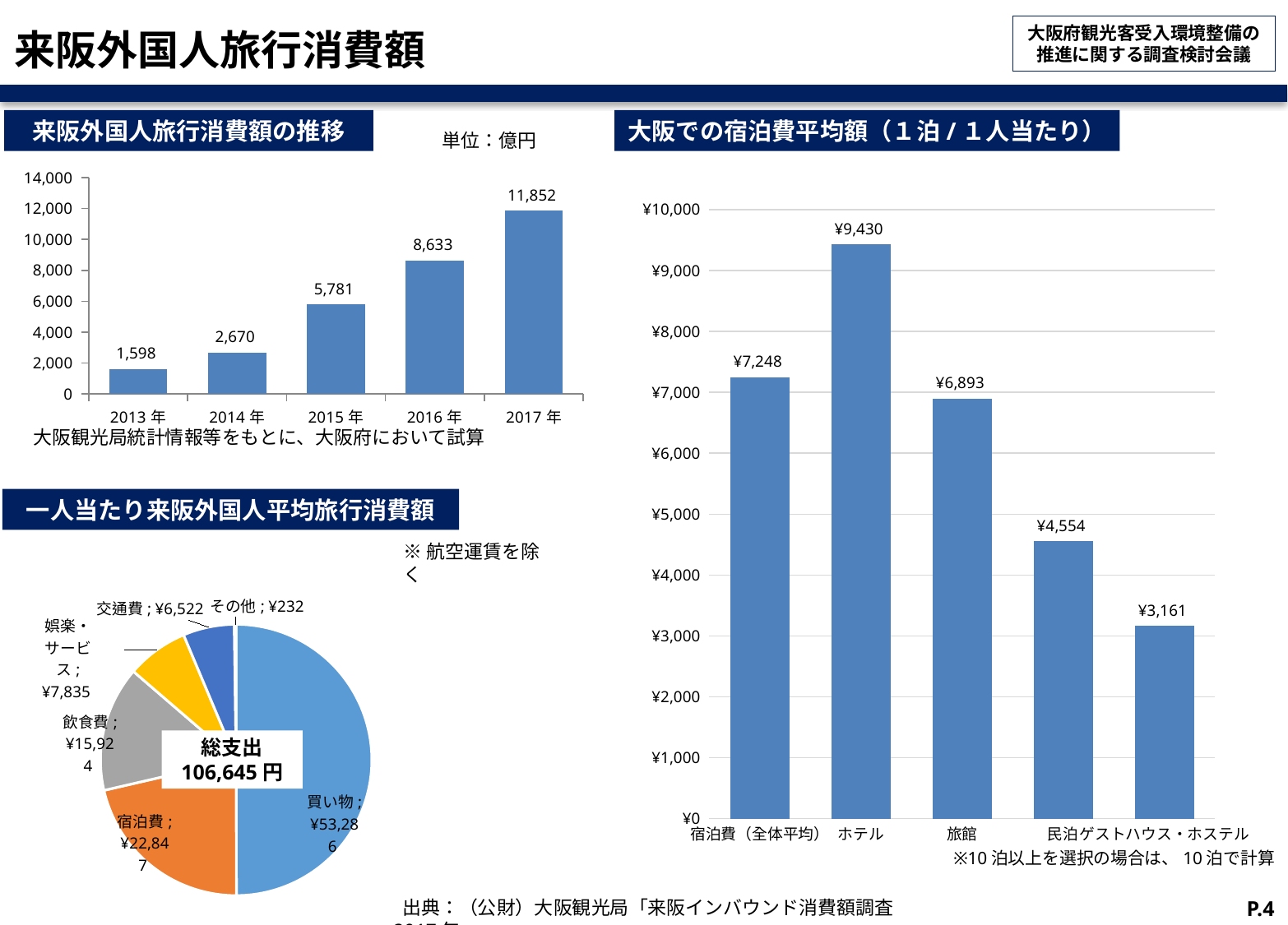
In the 来阪外国人旅行消費額の推移 chart, do the values rise or fall from 2013年 to 2017年? rise In the 一人当たり来阪外国人平均旅行消費額 pie chart, what is the value for 宿泊費? ¥22,847 In the 来阪外国人旅行消費額の推移 chart, which year has the lowest value? 2013年 In the 大阪での宿泊費平均額 chart, what is the value for 旅館? ¥6,893 In the 大阪での宿泊費平均額 chart, what is the value for ホテル? ¥9,430 In the 来阪外国人旅行消費額の推移 chart, what is the difference between the 2016年 and 2015年 values? 2,852 In the 来阪外国人旅行消費額の推移 chart, what is the value for 2017年? 11,852 In the 大阪での宿泊費平均額 chart, which category has the highest value? ホテル In the 大阪での宿泊費平均額 chart, which is larger: 宿泊費（全体平均） or 民泊ゲストハウス・ホステル? 宿泊費（全体平均） In the 来阪外国人旅行消費額の推移 chart, what is the value for 2014年? 2,670 In the 来阪外国人旅行消費額の推移 chart, what unit is stated for the values? 億円 In the 大阪での宿泊費平均額 chart, how many bars are plotted? 5